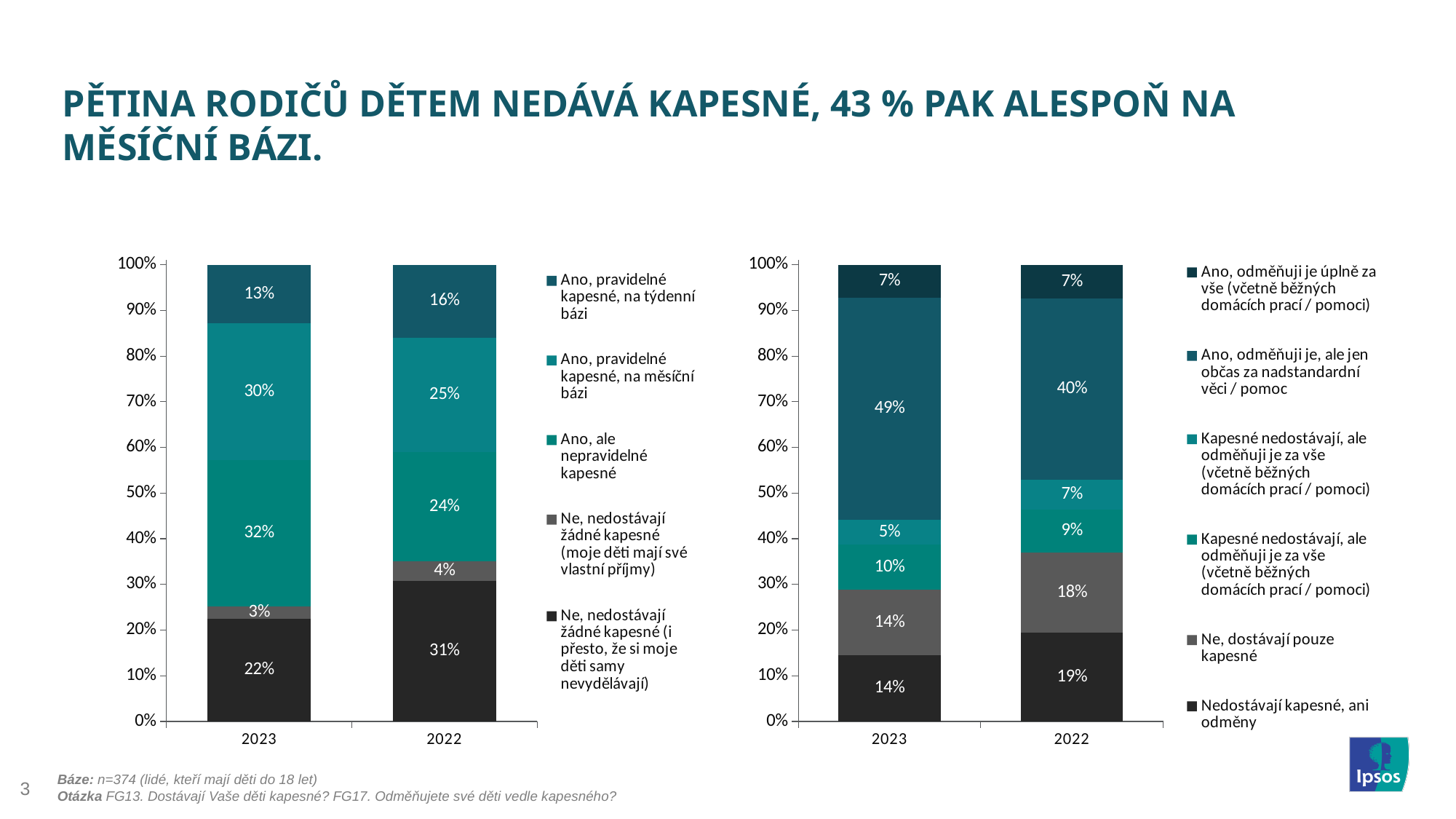
How many series does the legend of the right chart list? 6 What type of chart is the left chart? Stacked bar chart On the right chart, is the 2023 value for 'Ano, odměňuji je, ale jen občas za nadstandardní věci / pomoc' larger or smaller than the 2022 value? larger On the left chart, which segment is the smallest in the 2022 bar? Ne, nedostávají žádné kapesné (moje děti mají své vlastní příjmy) On the right chart, what is the difference between the 2022 and 2023 values for 'Nedostávají kapesné, ani odměny'? 5% On the left chart, what percentage of the 2023 bar is 'Ano, pravidelné kapesné, na měsíční bázi'? 30% On the right chart, what is the value for 'Ano, odměňuji je, ale jen občas za nadstandardní věci / pomoc' in 2023? 49% On the left chart, which segment is the largest in the 2023 bar? Ano, ale nepravidelné kapesné On the left chart, what is the difference between the 2022 and 2023 values for 'Ne, nedostávají žádné kapesné (i přesto, že si moje děti samy nevydělávají)'? 9% On the right chart, what is the value for 'Ne, dostávají pouze kapesné' in 2022? 18% On the left chart, what is the value for 'Ano, pravidelné kapesné, na týdenní bázi' in 2022? 16% How many series does the legend of the left chart list? 5